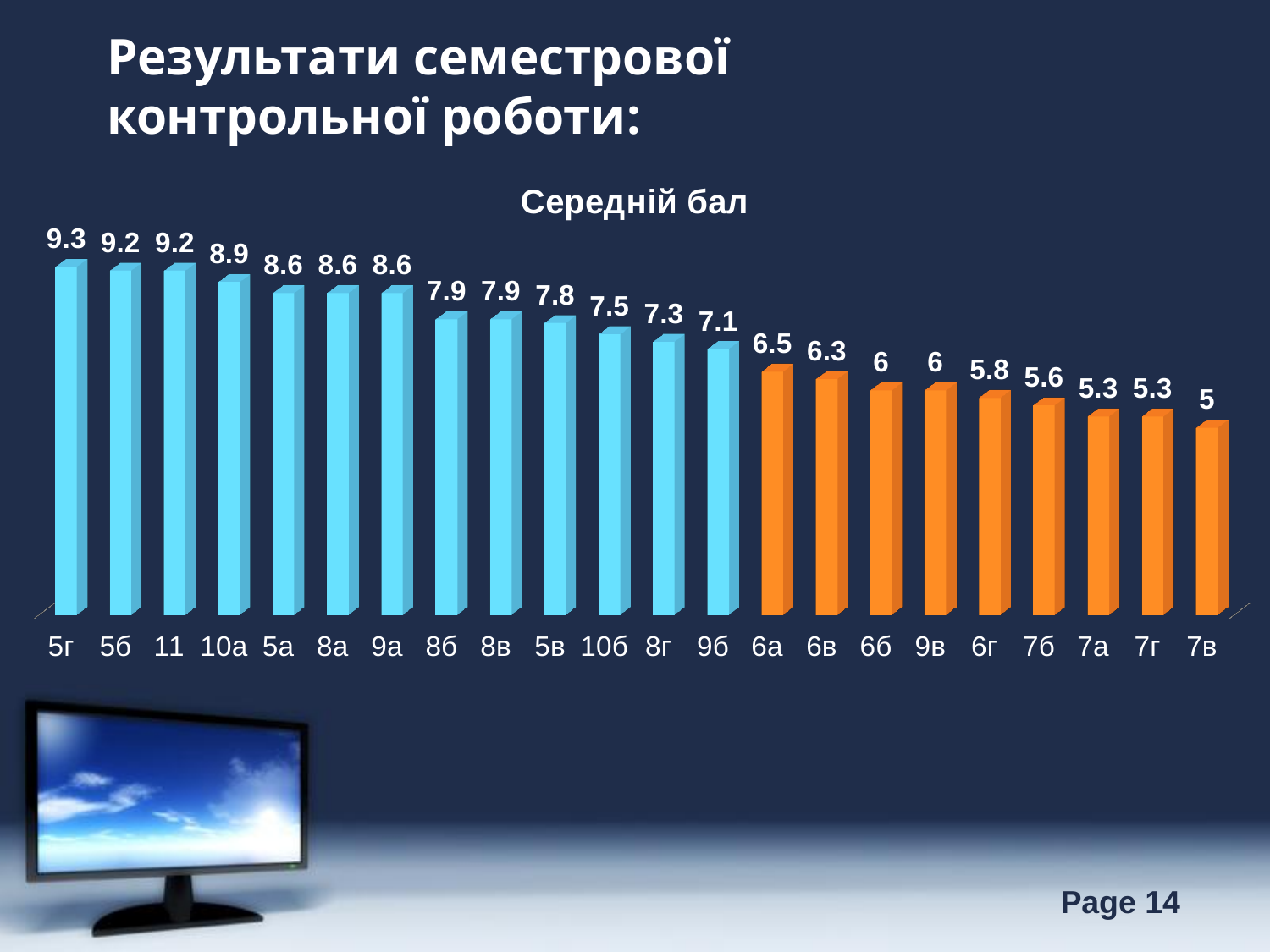
What is the value for 5г? 9.3 What is the value for 10б? 7.5 What is the difference between the values for 6а and 6в? 0.2 What is the title of the chart? Середній бал Which category has the lowest value? 7в How many categories are shown on the x axis? 22 What is the value for 9в? 6 What is the difference between the values for 5г and 7в? 4.3 Which is larger, the value for 8г or the value for 9б? 8г Which category has the highest value? 5г What is the value for 6г? 5.8 What kind of chart is this? bar chart